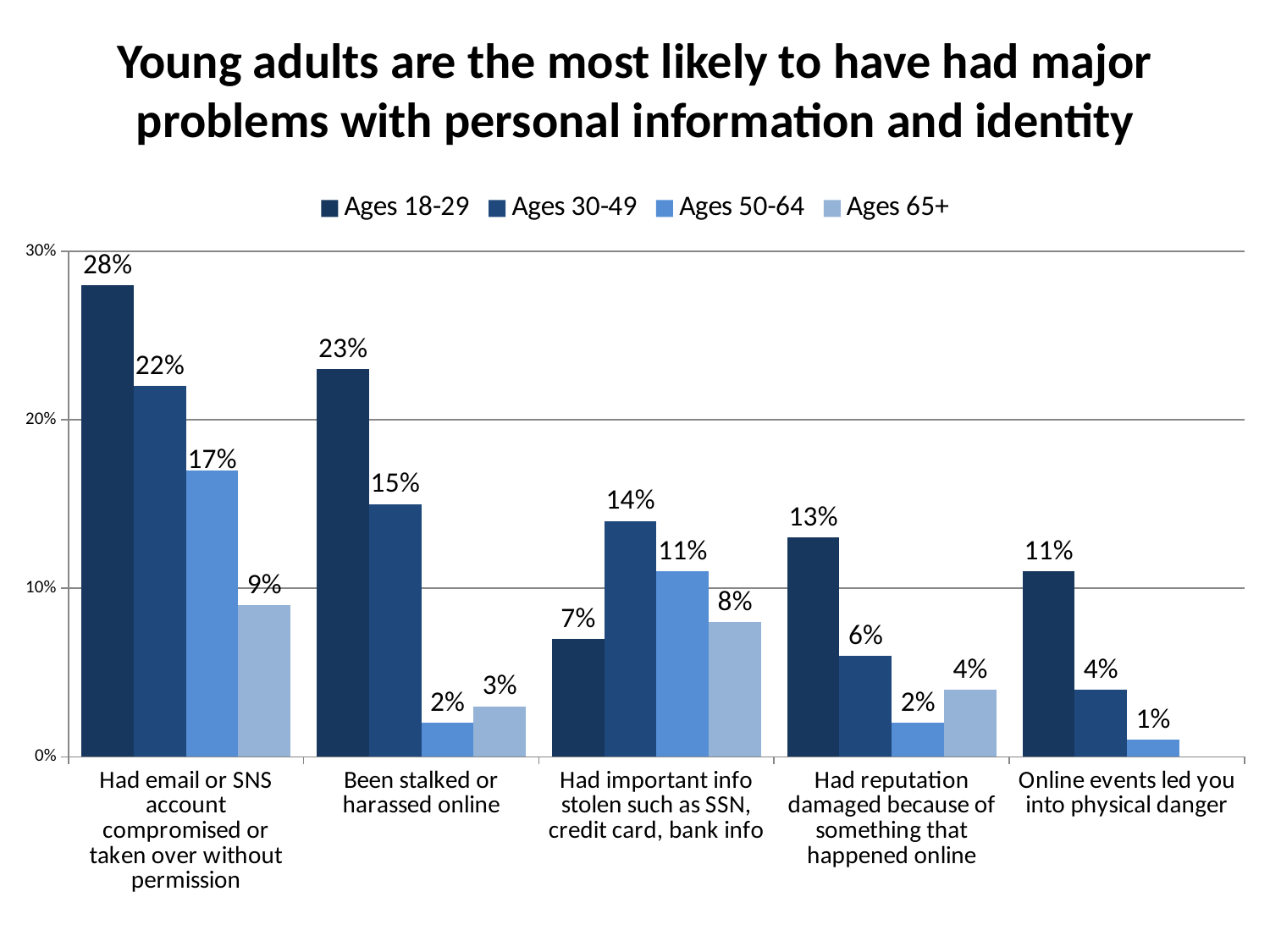
How many problem categories are shown on the x axis? 5 Is the value for ages 18-29 for 'Online events led you into physical danger' greater or less than 10%? greater For 'Had reputation damaged because of something that happened online', which is larger: the value for ages 18-29 or ages 30-49? Ages 18-29 What is the value for ages 30-49 for 'Had important info stolen such as SSN, credit card, bank info'? 14% What is the value for ages 50-64 for 'Been stalked or harassed online'? 2% What is the title of the slide? Young adults are the most likely to have had major problems with personal information and identity How many age groups does the legend list? 4 What type of chart is shown on the slide? Bar chart Which age group has the highest value for 'Had important info stolen such as SSN, credit card, bank info'? Ages 30-49 What is the difference between ages 18-29 and ages 30-49 for 'Been stalked or harassed online'? 8% What percentage of ages 18-29 had their email or SNS account compromised or taken over without permission? 28% Which age group has the lowest value for 'Had email or SNS account compromised or taken over without permission'? Ages 65+